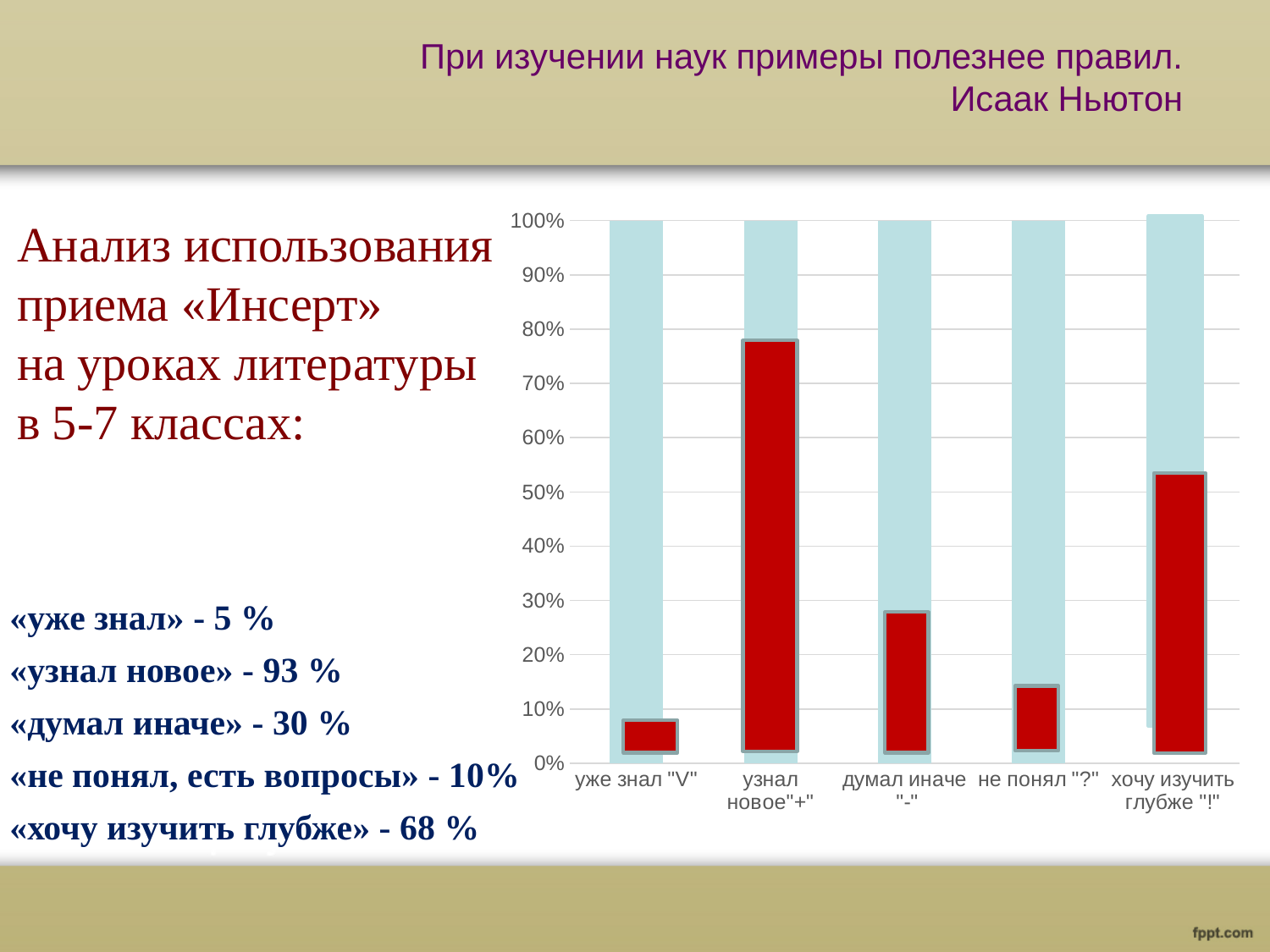
Is the red bar for хочу изучить глубже "!" greater or less than 40%? greater Which category has the tallest red bar? узнал новое"+" Is the red bar for узнал новое"+" greater or less than 70%? greater Is the red bar for думал иначе "-" greater or less than 20%? greater What colour are the data bars in the chart? red Which red bar is taller: хочу изучить глубже "!" or думал иначе "-"? хочу изучить глубже "!" Which category has the shortest red bar? уже знал "V" What kind of chart is shown on the slide? bar chart How many categories are shown on the x axis of the chart? 5 What is the highest value shown on the vertical axis of the chart? 100%